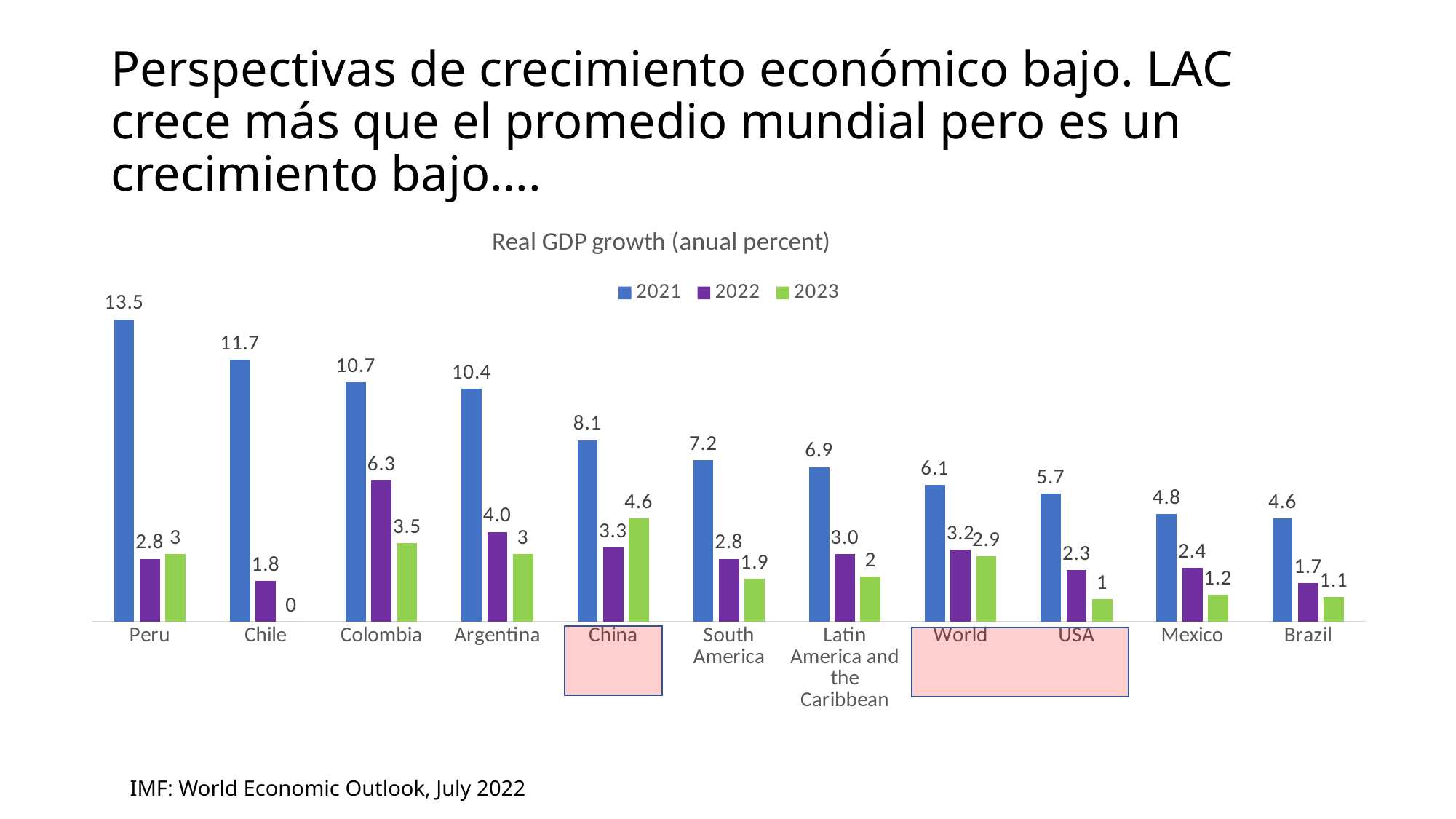
What is the 2023 real GDP growth value for China? 4.6 What is the 2022 real GDP growth value for Colombia? 6.3 What is the 2021 real GDP growth value for Peru? 13.5 How many series does the legend list? 3 What is the difference between the 2021 and 2022 values for Chile? 9.9 Do the 2021 values rise or fall from Peru to Brazil along the x axis? Fall What is the title of the chart? Real GDP growth (anual percent) What kind of chart is shown on the slide? Bar chart Which is larger, the 2023 value for World or the 2023 value for USA? World Which category has the lowest 2023 value? Chile How many categories are shown on the x axis? 11 Which category has the highest 2021 value? Peru